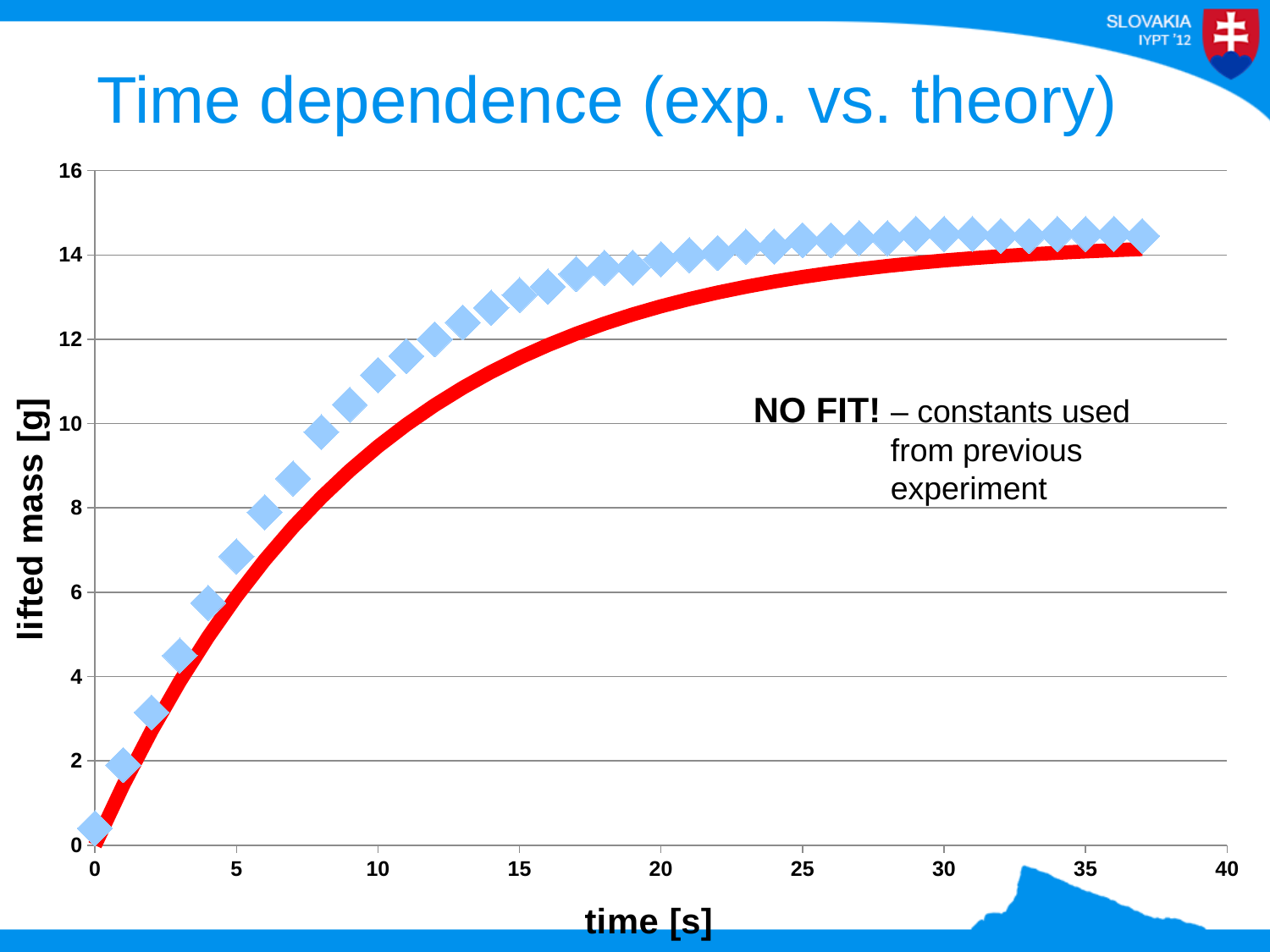
Is the lifted mass of the blue diamond data points at time 10 s greater or less than 10 g? greater At time 10 s, which is higher: the blue diamond data points or the red curve? The blue diamond data points What is the title of the chart? Time dependence (exp. vs. theory) Is the lifted mass of the red curve at time 5 s greater or less than 4 g? greater Is the lifted mass of the red curve at time 20 s greater or less than 14 g? less What is the label of the vertical axis? lifted mass [g] Do the plotted values rise or fall as time increases along the x axis? Rise At which time do the blue diamond data points have their lowest lifted mass? 0 s What kind of chart is shown on the slide? Scatter chart with a line